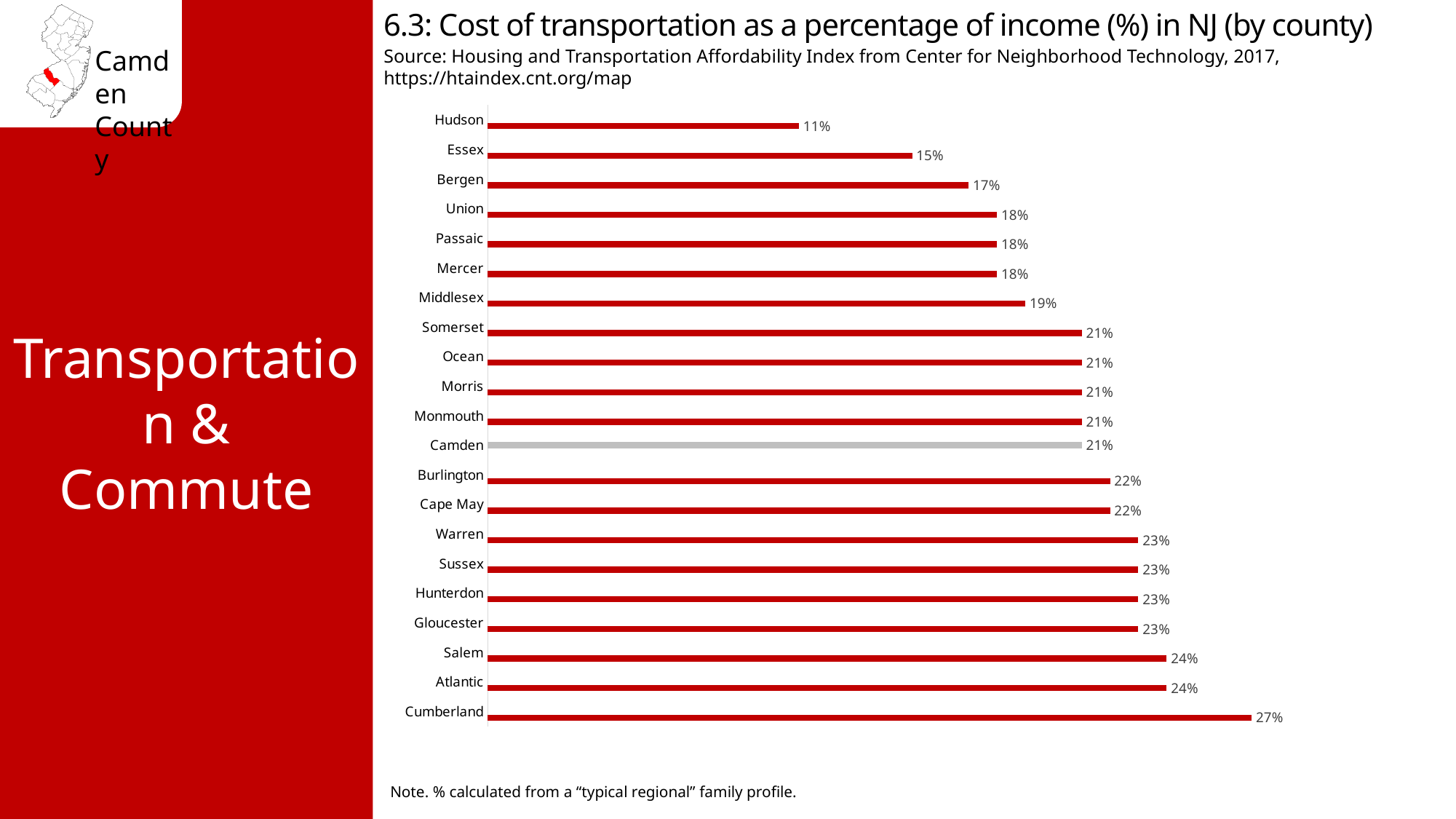
What is the cost of transportation as a percentage of income for Hudson County? 11% How many counties are shown in the chart? 21 What is the difference between the values for Salem and Camden? 3% Which has a higher value, Warren or Middlesex? Warren Which county's bar is shown in gray instead of red? Camden Which county has the lowest cost of transportation as a percentage of income? Hudson Which has a higher value, Essex or Bergen? Bergen Which county has the highest cost of transportation as a percentage of income? Cumberland What is the cost of transportation as a percentage of income for Middlesex County? 19% What is the difference between the values for Cumberland and Hudson? 16% What is the cost of transportation as a percentage of income for Camden County? 21% What type of chart is shown on the slide? Bar chart